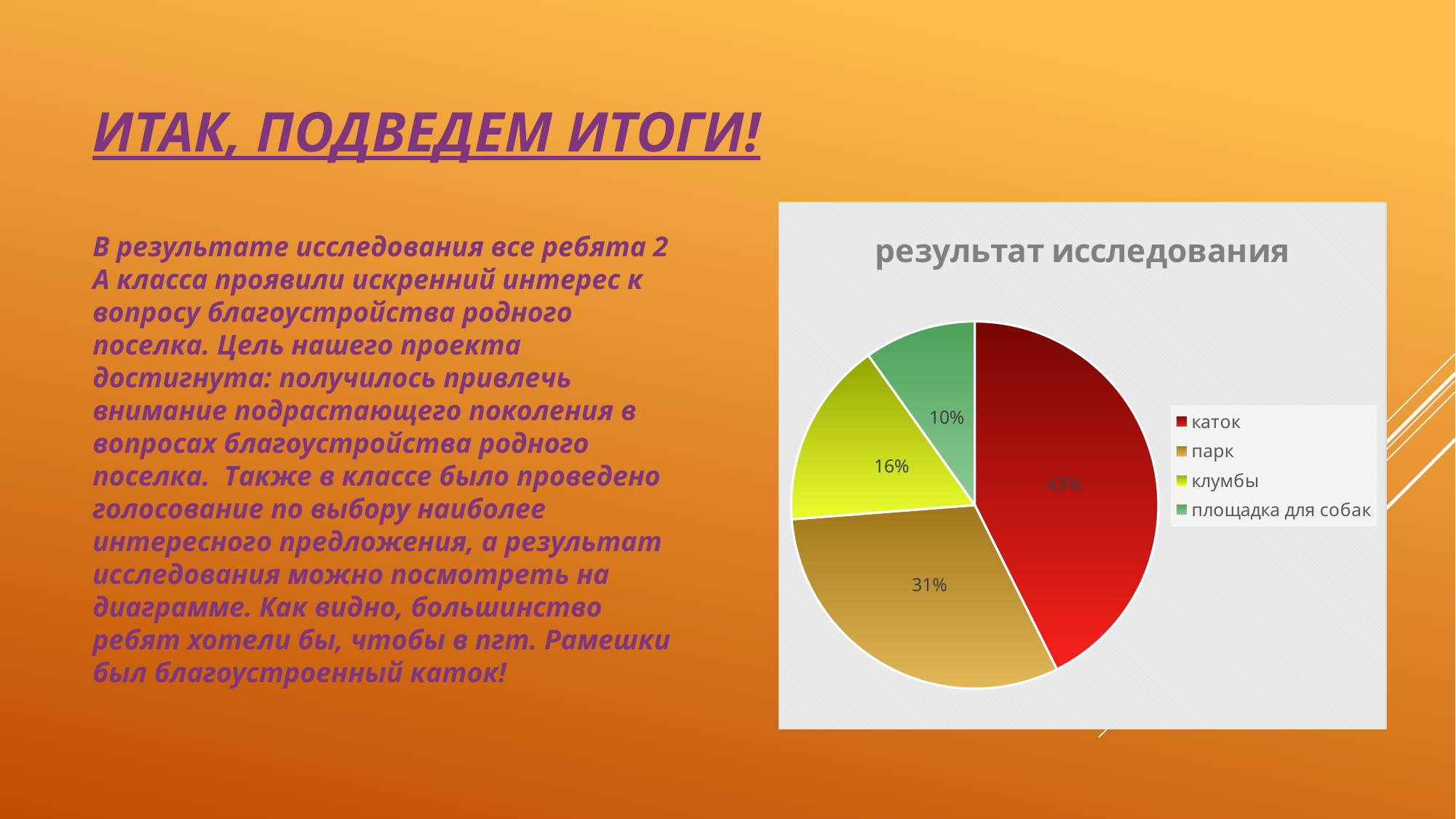
Which category has the largest slice of the pie? каток What share of the pie does каток have? 43% What share of the pie does площадка для собак have? 10% What colour is the slice for каток? red What kind of chart is shown on the slide? pie chart Which category has the smallest slice of the pie? площадка для собак What share of the pie does клумбы have? 16% How many categories does the pie chart have? 4 What is the title of the chart? результат исследования Which is larger, the share for клумбы or the share for площадка для собак? клумбы What share of the pie does парк have? 31% What is the difference between the shares of каток and парк? 12%